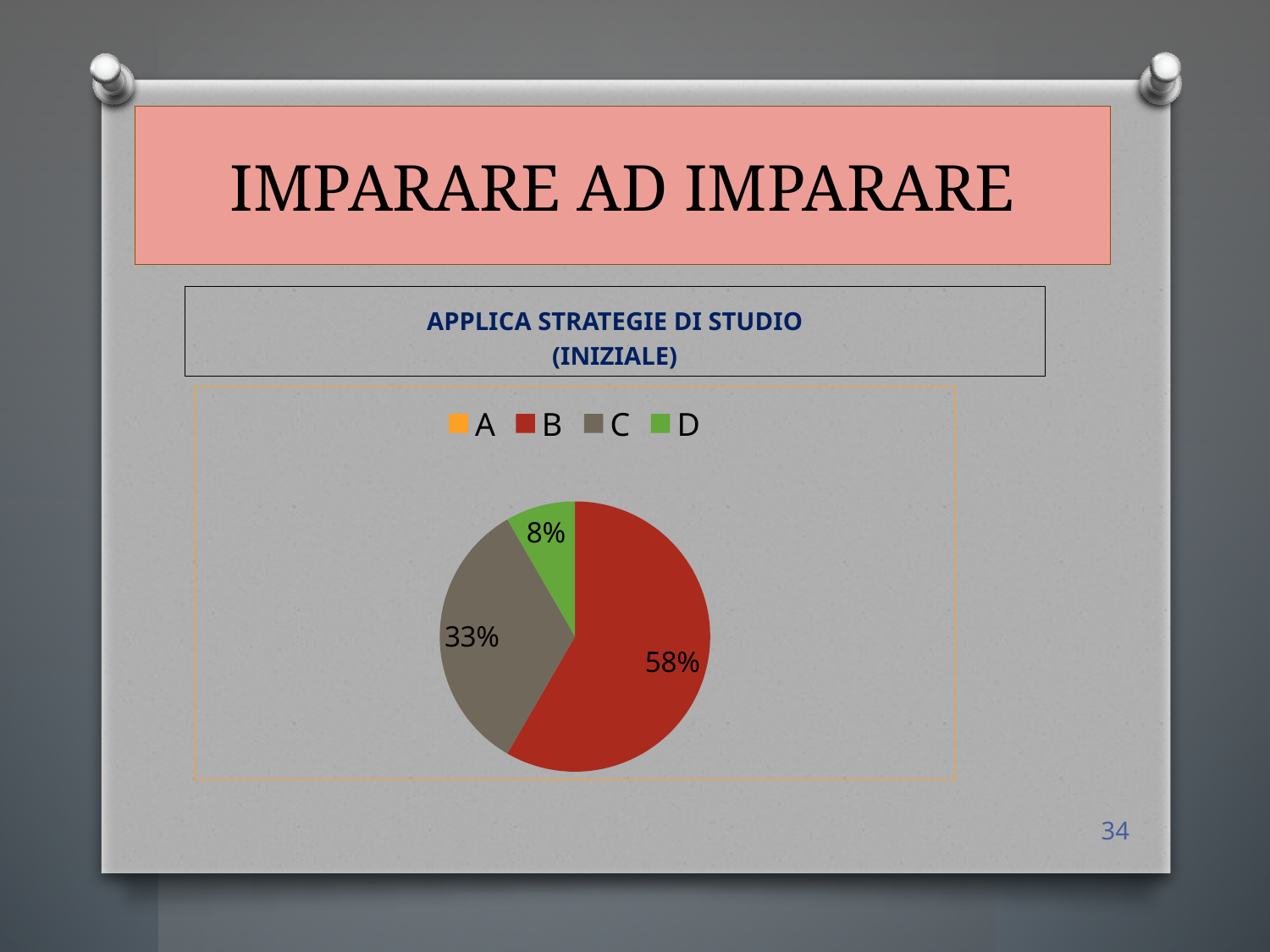
How many entries does the legend of the pie chart list? 4 What is the difference in percentage points between slice C and slice D? 25 What percentage does slice B represent in the pie chart? 58% What percentage does slice D represent in the pie chart? 8% Which category has the largest slice of the pie chart? B Which slice is larger, C or D? C What is the difference in percentage points between slice B and slice C? 25 What colour is the slice for category B in the pie chart? red What percentage does slice C represent in the pie chart? 33% What kind of chart is shown on the slide? pie chart Which of the labelled slices in the pie chart is the smallest? D What is the title shown above the pie chart? APPLICA STRATEGIE DI STUDIO (INIZIALE)